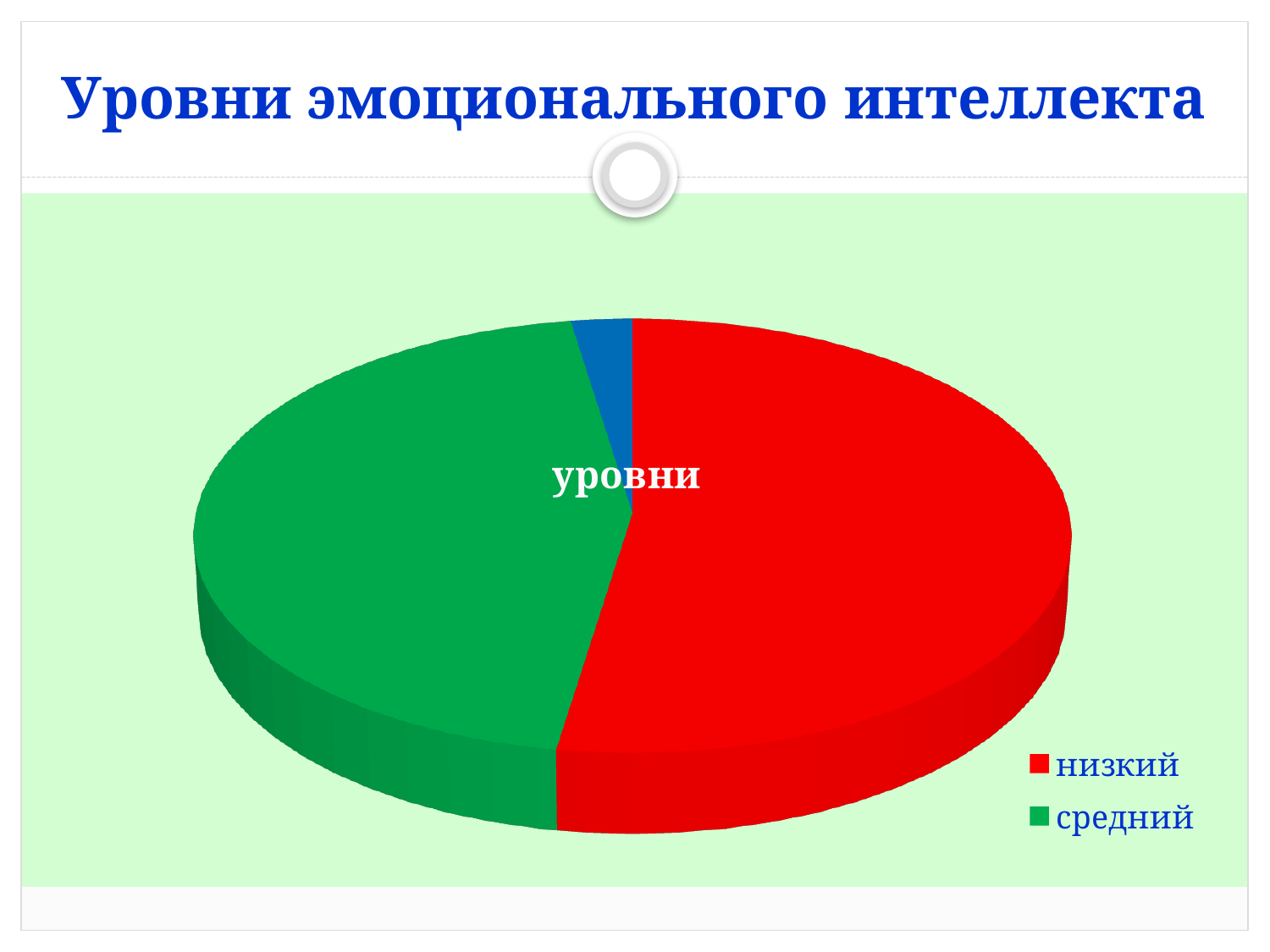
What kind of chart is shown on the slide? pie chart What is the title printed on the chart? уровни Which slice is larger, низкий or средний? низкий What colour is the slice for низкий? red How many entries does the chart legend list? 2 Is the share of the низкий slice greater or less than 25%? greater Which of the two legend categories has the smaller slice? средний How many slices does the pie chart have? 3 Which category has the largest slice of the pie? низкий